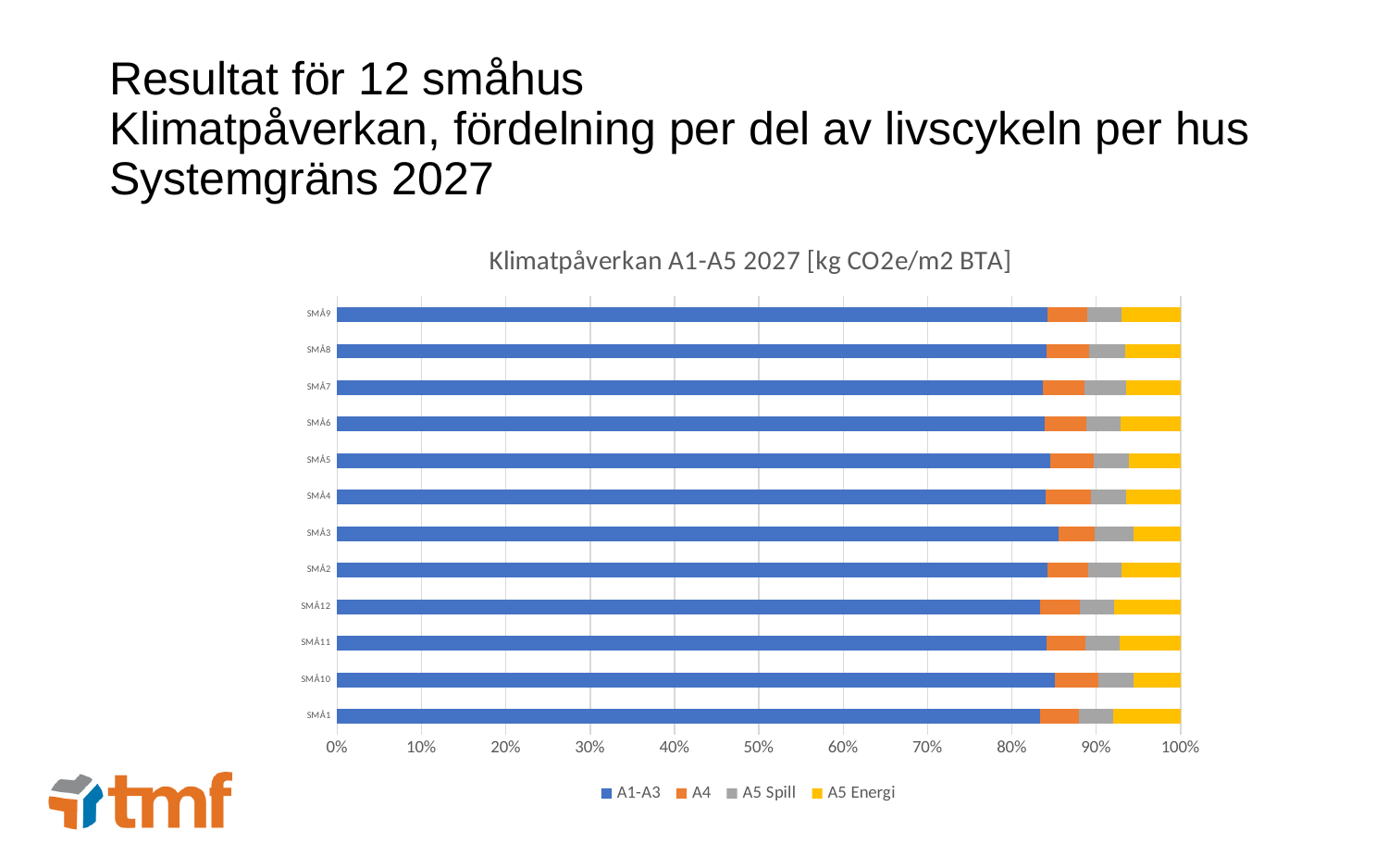
What is the total of the stacked bar for SMÅ12? 100% What is the title of the chart? Klimatpåverkan A1-A5 2027 [kg CO2e/m2 BTA] Is the A1-A3 share for SMÅ9 greater or less than 70%? greater Which series makes up the largest share of every bar in the chart? A1-A3 How many houses (categories) are plotted in the chart? 12 For SMÅ5, which is larger: the A1-A3 segment or the A4 segment? A1-A3 For SMÅ10, which is larger: the A5 Energi segment or the A5 Spill segment? A5 Energi Is the A1-A3 share for SMÅ1 greater or less than 80%? greater What kind of chart is shown on the slide? bar chart How many series does the chart legend list? 4 Which series is shown in blue in the chart? A1-A3 Is the A1-A3 share for SMÅ3 greater or less than 90%? less